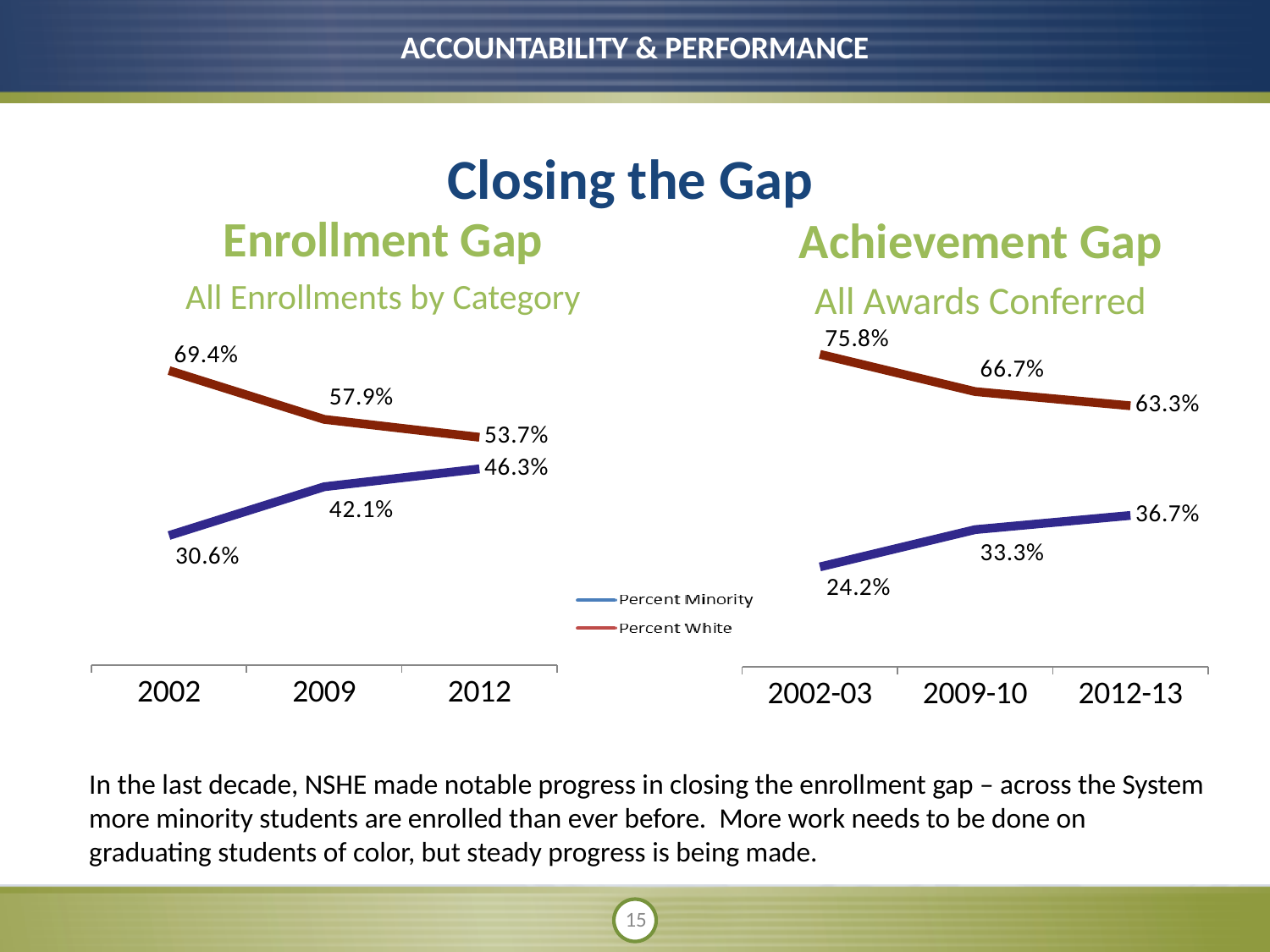
In the All Enrollments by Category chart, what is the Percent White value for 2002? 69.4% How many series does the legend list? 2 In the All Awards Conferred chart, in which year is the Percent White value highest? 2002-03 What kind of chart is the All Awards Conferred chart? line chart In the All Awards Conferred chart, what is the Percent White value for 2012-13? 63.3% In the All Enrollments by Category chart, in which year is the Percent Minority value lowest? 2002 In the All Awards Conferred chart, does the Percent Minority line rise or fall from 2002-03 to 2012-13? rise In the All Enrollments by Category chart, what is the Percent Minority value for 2012? 46.3% In the All Awards Conferred chart, what is the Percent Minority value for 2009-10? 33.3% In the All Enrollments by Category chart, what is the difference between the Percent White and Percent Minority values in 2012? 7.4% In the All Awards Conferred chart, what is the difference between the Percent Minority values for 2012-13 and 2002-03? 12.5% In the All Enrollments by Category chart, does the Percent White line rise or fall from 2002 to 2012? fall